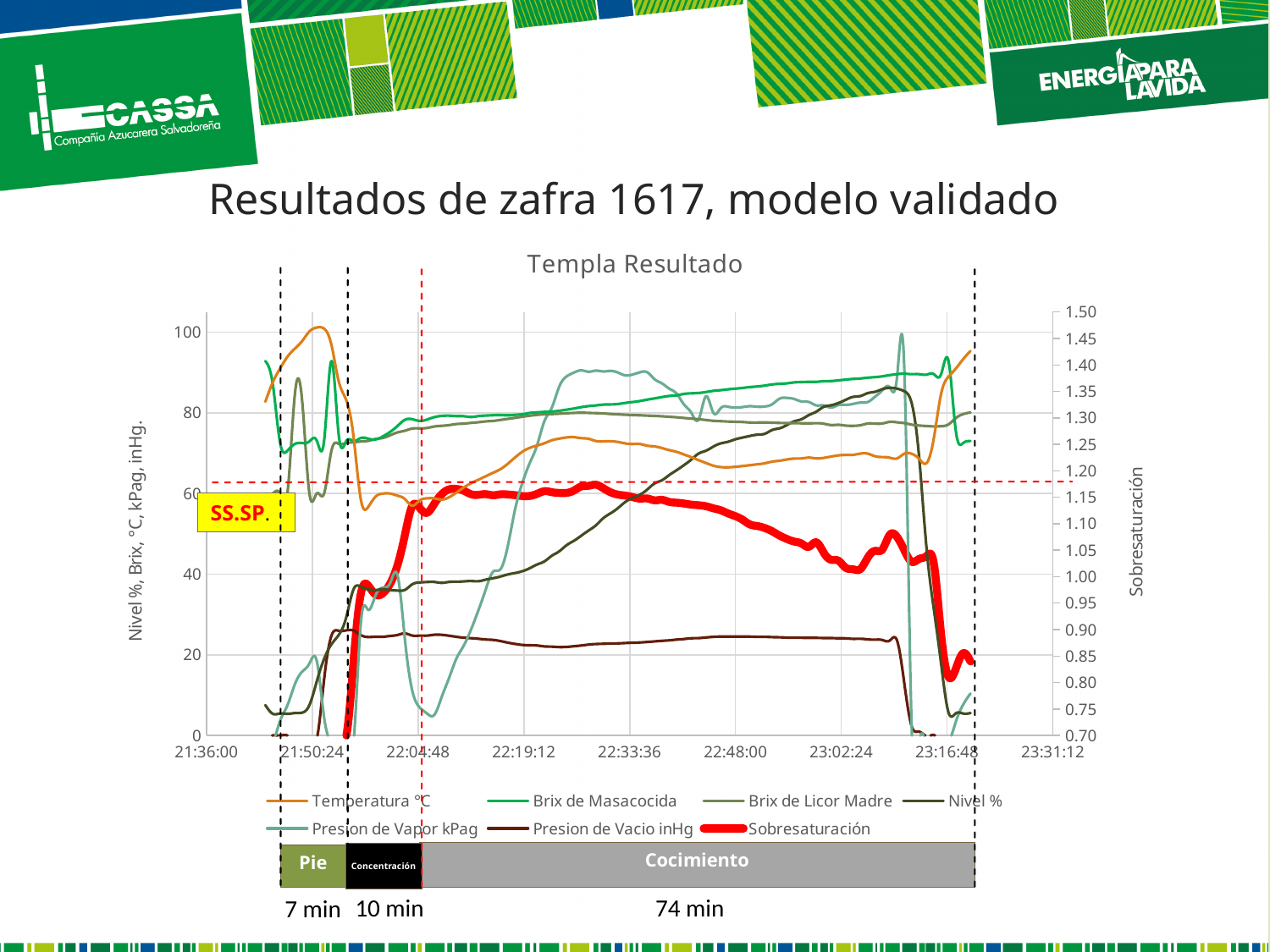
At 23:02:24, which is larger: Nivel % or Presion de Vacio inHg? Nivel % How many process phases are marked in the bar below the chart (Pie, Concentración, Cocimiento)? 3 What kind of chart is shown on the slide? line chart How long is the Pie phase according to the annotation below the chart? 7 min Is the value of Presion de Vacio inHg at 22:48:00 greater or less than 40? less Does the Nivel % series rise or fall between 22:04:48 and 23:02:24? rise How long is the Cocimiento phase according to the annotation below the chart? 74 min Is the value of Nivel % at 23:02:24 greater or less than 60? greater What is the title of the chart? Templa Resultado How many series does the chart legend list? 7 Is the Sobresaturación value at 23:16:48 greater or less than 1.00 on the right axis? less Which series is drawn as the thick red line? Sobresaturación